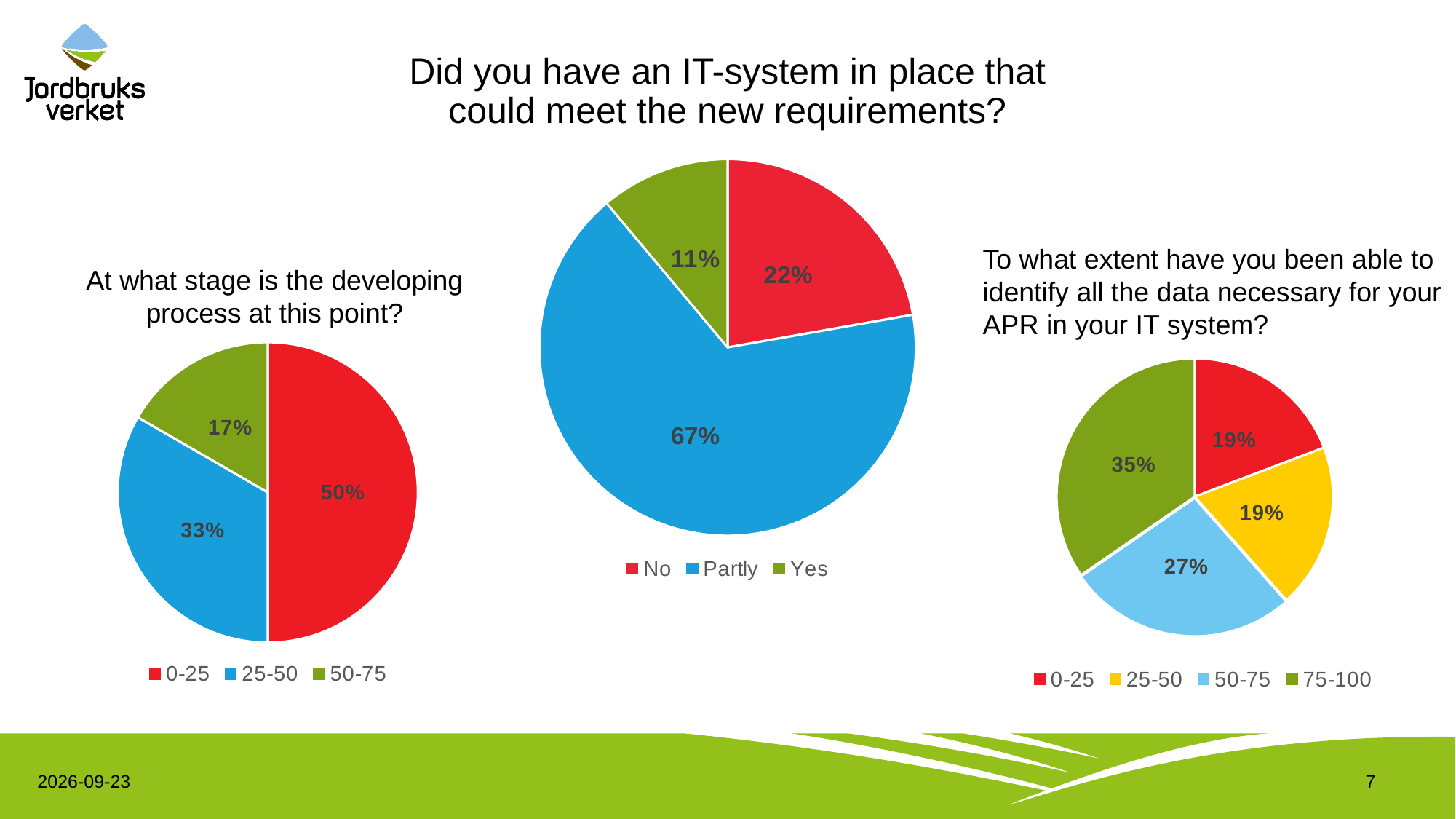
In the center pie chart 'Did you have an IT-system in place that could meet the new requirements?', how many entries does the legend list? 3 In the center pie chart 'Did you have an IT-system in place that could meet the new requirements?', which category has the smallest slice? Yes In the right pie chart 'To what extent have you been able to identify all the data necessary for your APR in your IT system?', which is larger, the '50-75' slice or the '75-100' slice? 75-100 In the right pie chart 'To what extent have you been able to identify all the data necessary for your APR in your IT system?', what share is labelled for '75-100'? 35% In the center pie chart 'Did you have an IT-system in place that could meet the new requirements?', what share is labelled for 'Partly'? 67% In the right pie chart 'To what extent have you been able to identify all the data necessary for your APR in your IT system?', how many slices does the pie have? 4 In the left pie chart 'At what stage is the developing process at this point?', which category has the largest slice? 0-25 What type of chart is the center chart 'Did you have an IT-system in place that could meet the new requirements?'? Pie chart In the left pie chart 'At what stage is the developing process at this point?', what is the difference in percentage points between the '25-50' and '50-75' slices? 16 In the right pie chart 'To what extent have you been able to identify all the data necessary for your APR in your IT system?', what share is labelled for '50-75'? 27%